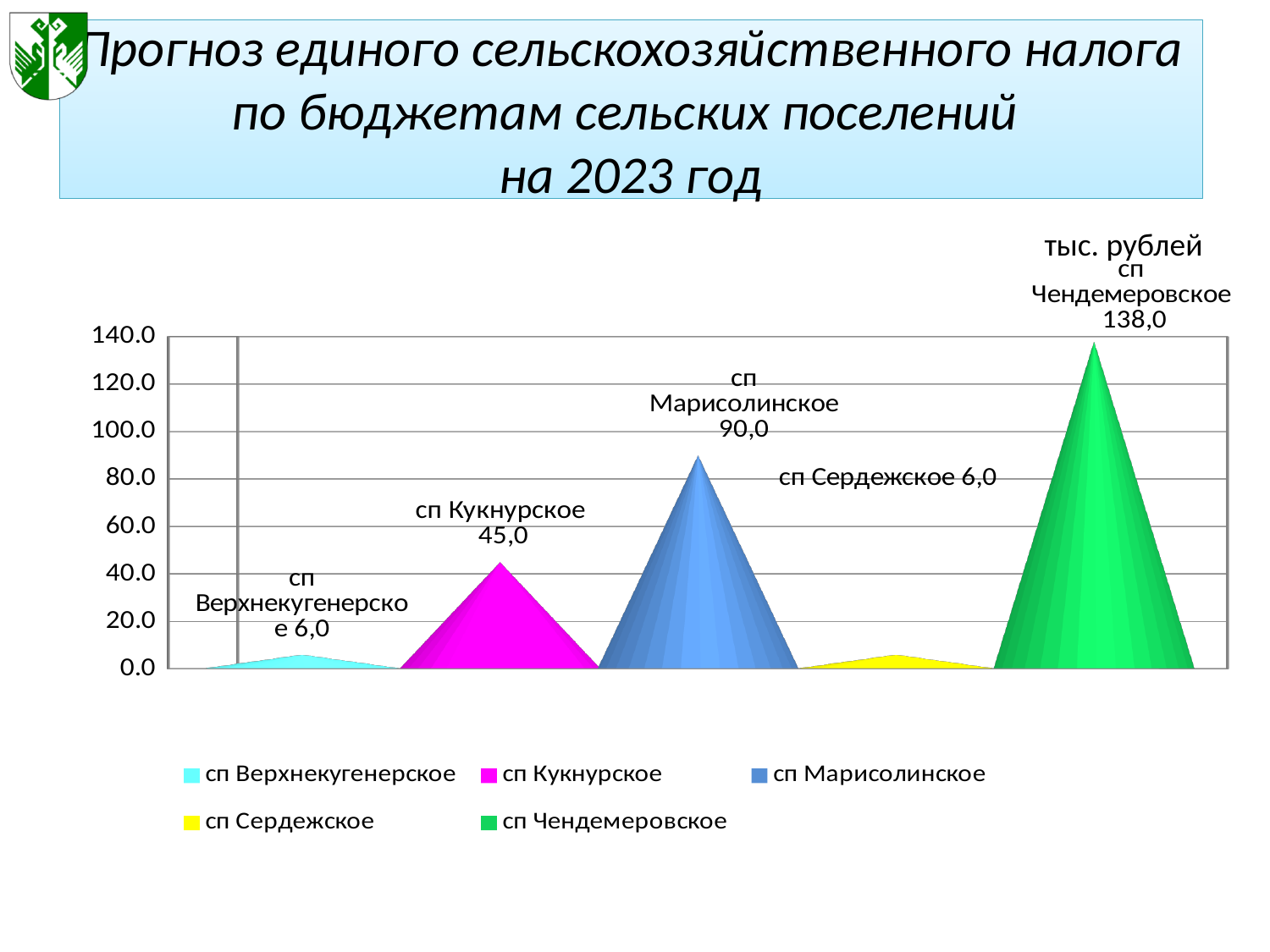
What is the forecast value for сп Кукнурское? 45,0 What unit of measurement is indicated for the chart values? тыс. рублей How many entries does the legend list? 5 Which is larger, the value for сп Кукнурское or the value for сп Верхнекугенерское? сп Кукнурское What is the forecast value for сп Сердежское? 6,0 Which settlement has the highest forecast value? сп Чендемеровское Is the value for сп Марисолинское greater or less than 100.0? less What is the difference between the values for сп Чендемеровское and сп Марисолинское? 48,0 What is the difference between the values for сп Марисолинское and сп Кукнурское? 45,0 What is the forecast value for сп Марисолинское? 90,0 How many settlements are shown in the chart? 5 What is the forecast value for сп Чендемеровское? 138,0